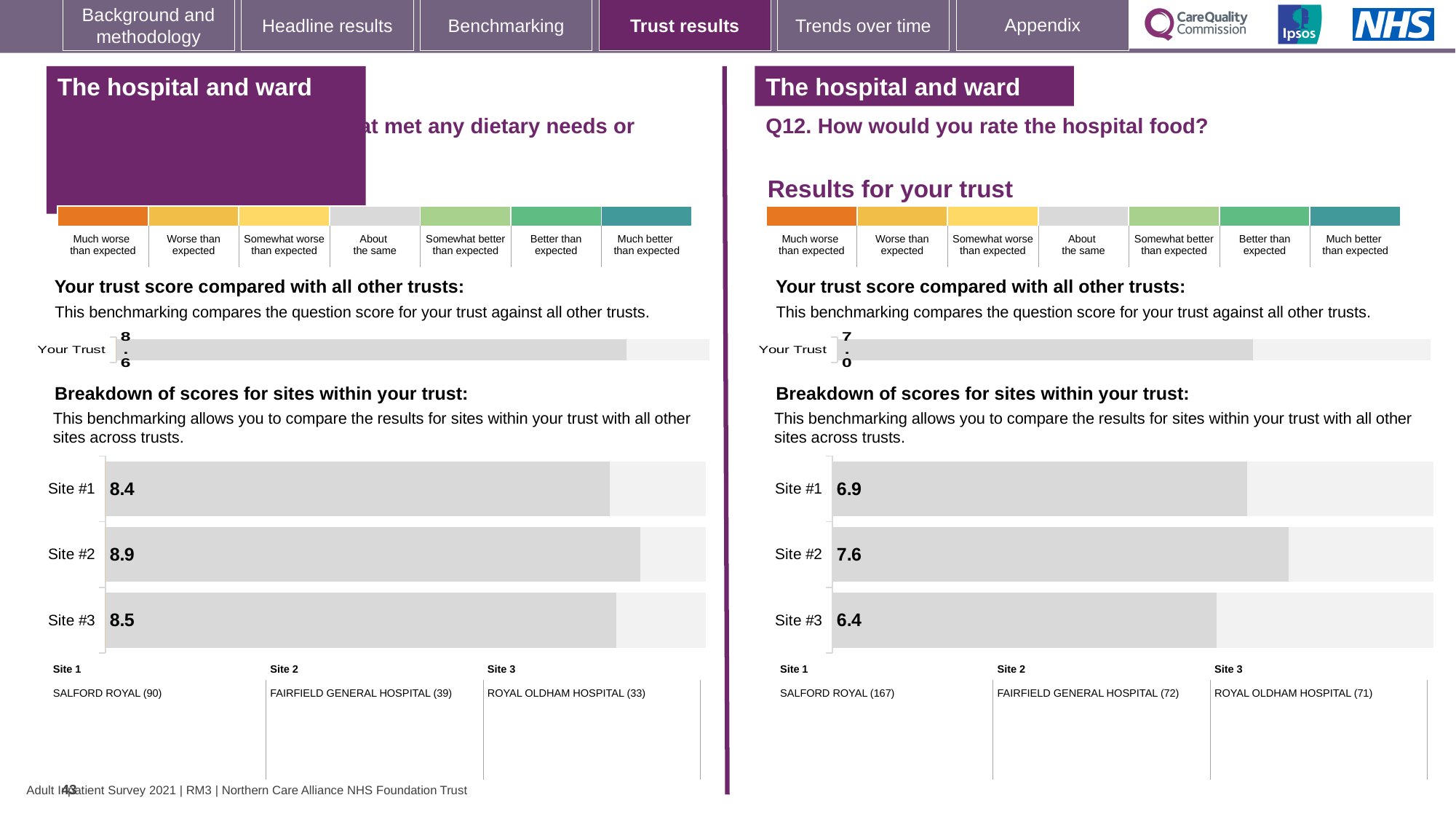
On the left-hand site breakdown chart, what is the difference between the scores for Site #2 and Site #1? 0.5 What kind of chart is used for the breakdown of scores for sites on the right-hand side of the slide? Bar chart On the right-hand chart (Q12. How would you rate the hospital food?), which site has the highest score? Site #2 How many sites are shown in the site breakdown chart on the right-hand side of the slide? 3 On the left-hand site breakdown chart, what is the score for Site #1? 8.4 On the right-hand chart (Q12. How would you rate the hospital food?), which site has the lowest score? Site #3 On the right-hand chart (Q12. How would you rate the hospital food?), what is the difference between the scores for Site #2 and Site #3? 1.2 On the right-hand chart (Q12. How would you rate the hospital food?), what is the score for Site #3? 6.4 On the left-hand site breakdown chart, which site has the highest score? Site #2 On the right-hand chart (Q12. How would you rate the hospital food?), what is the score for Site #2? 7.6 On the right-hand 'Your Trust' bar for Q12 (hospital food), what is the trust score shown? 7.0 On the left-hand site breakdown chart, what is the score for Site #2? 8.9